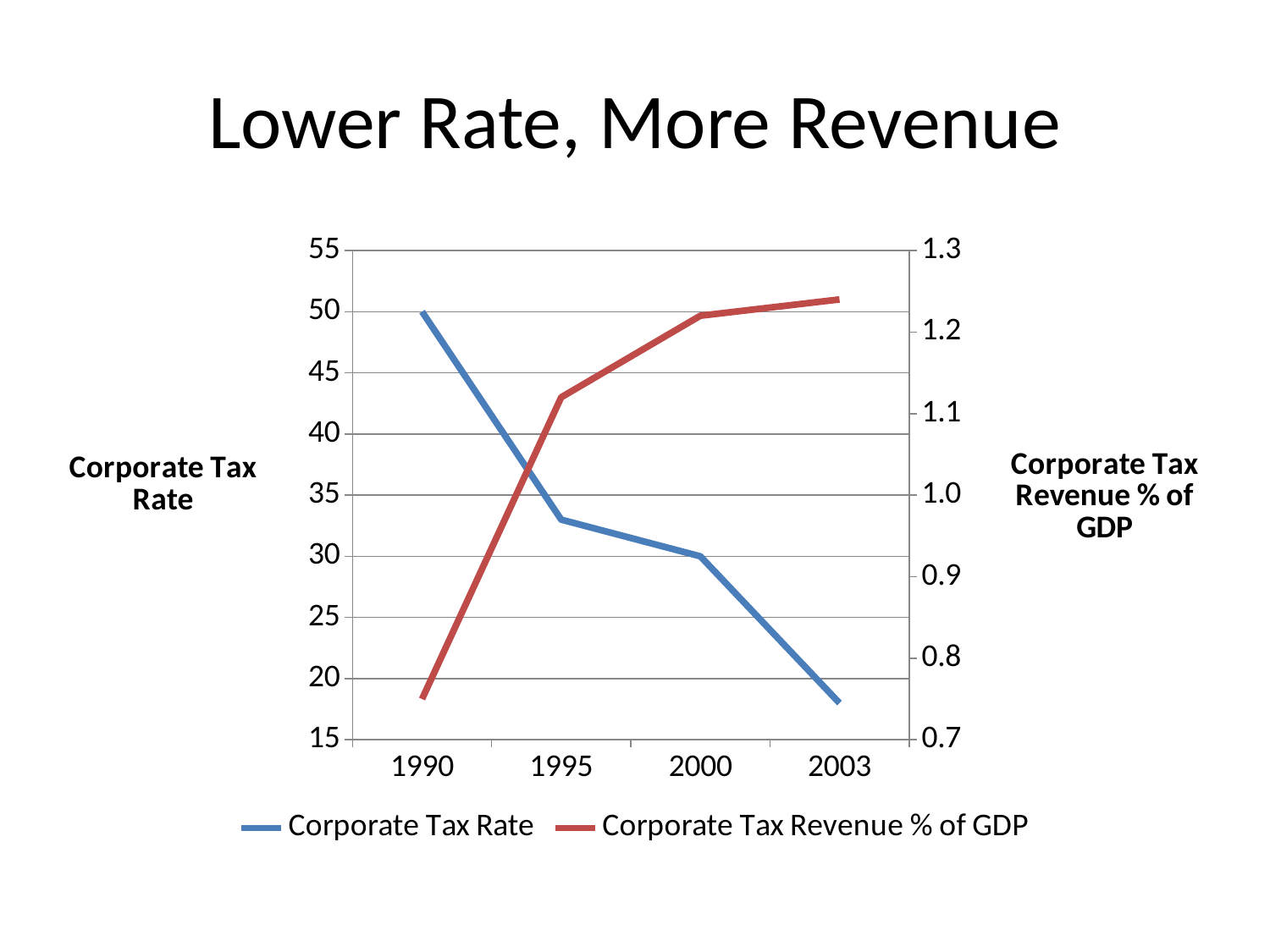
Is Corporate Tax Revenue % of GDP in 1990 greater or less than 0.8? less Is the Corporate Tax Rate in 1995 greater or less than 30? greater Is Corporate Tax Revenue % of GDP in 2000 greater or less than 1.2? greater Does the Corporate Tax Rate rise or fall from 1990 to 2003? fall In which year is Corporate Tax Revenue % of GDP lowest? 1990 Does Corporate Tax Revenue % of GDP rise or fall from 1990 to 2003? rise What is the title of the slide? Lower Rate, More Revenue How many years are plotted along the x axis? 4 In which year is the Corporate Tax Rate highest? 1990 What kind of chart is shown on the slide? line chart How many series does the legend list? 2